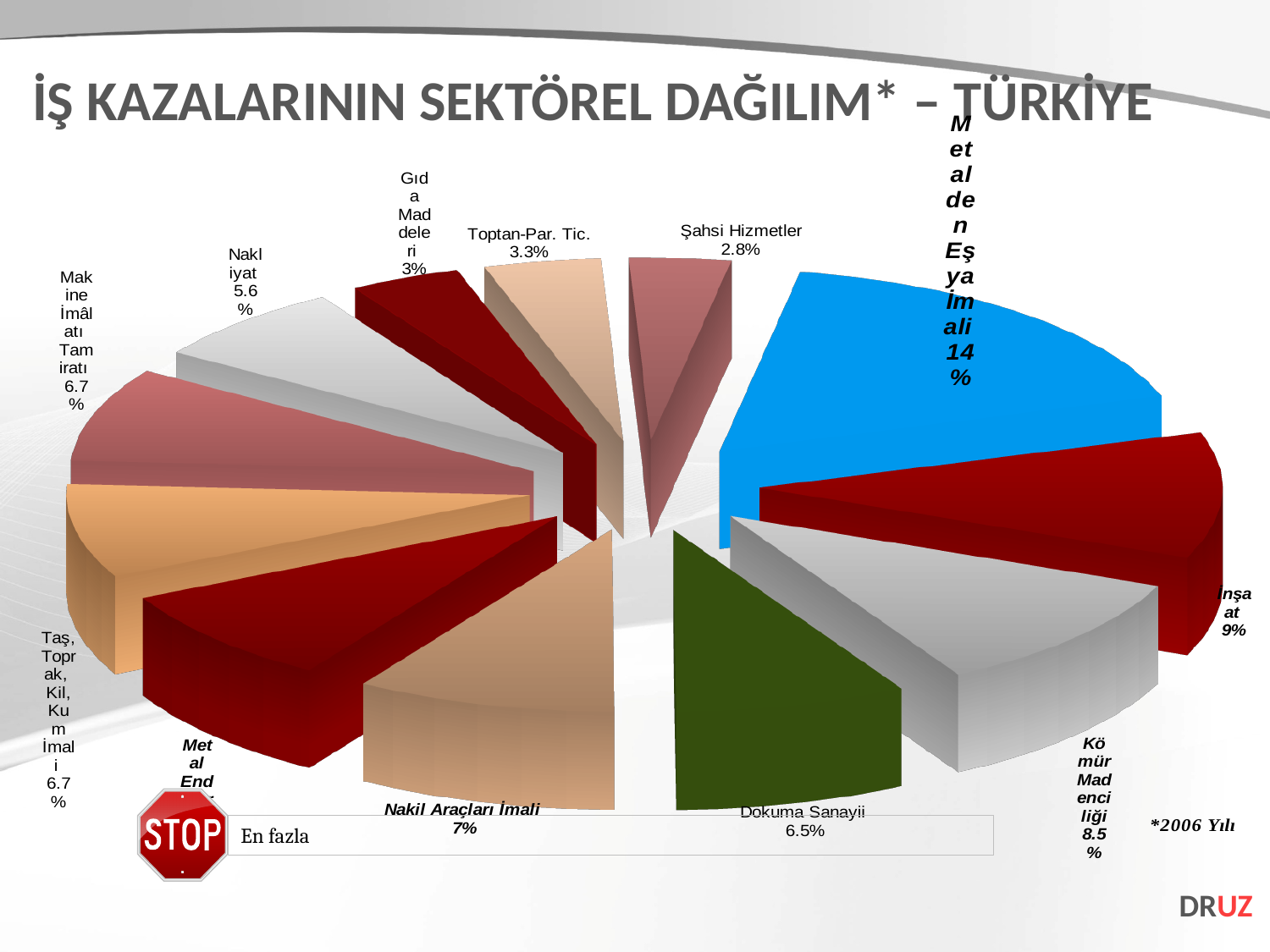
Which has a larger share, İnşaat or Kömür Madenciliği? İnşaat What is the share for Nakil Araçları İmali? 7% Which sector has the largest share of work accidents? Metalden Eşya İmali What is the share for Dokuma Sanayii? 6.5% What is the share for Kömür Madenciliği? 8.5% What is the difference in percentage points between Metalden Eşya İmali and İnşaat? 5 What is the share for İnşaat? 9% Which year does the footnote say the data refers to? 2006 What type of chart is shown on the slide? Pie chart What is the share for Şahsi Hizmetler? 2.8% Which sector has the smallest share of work accidents? Şahsi Hizmetler What is the share for Metalden Eşya İmali? 14%